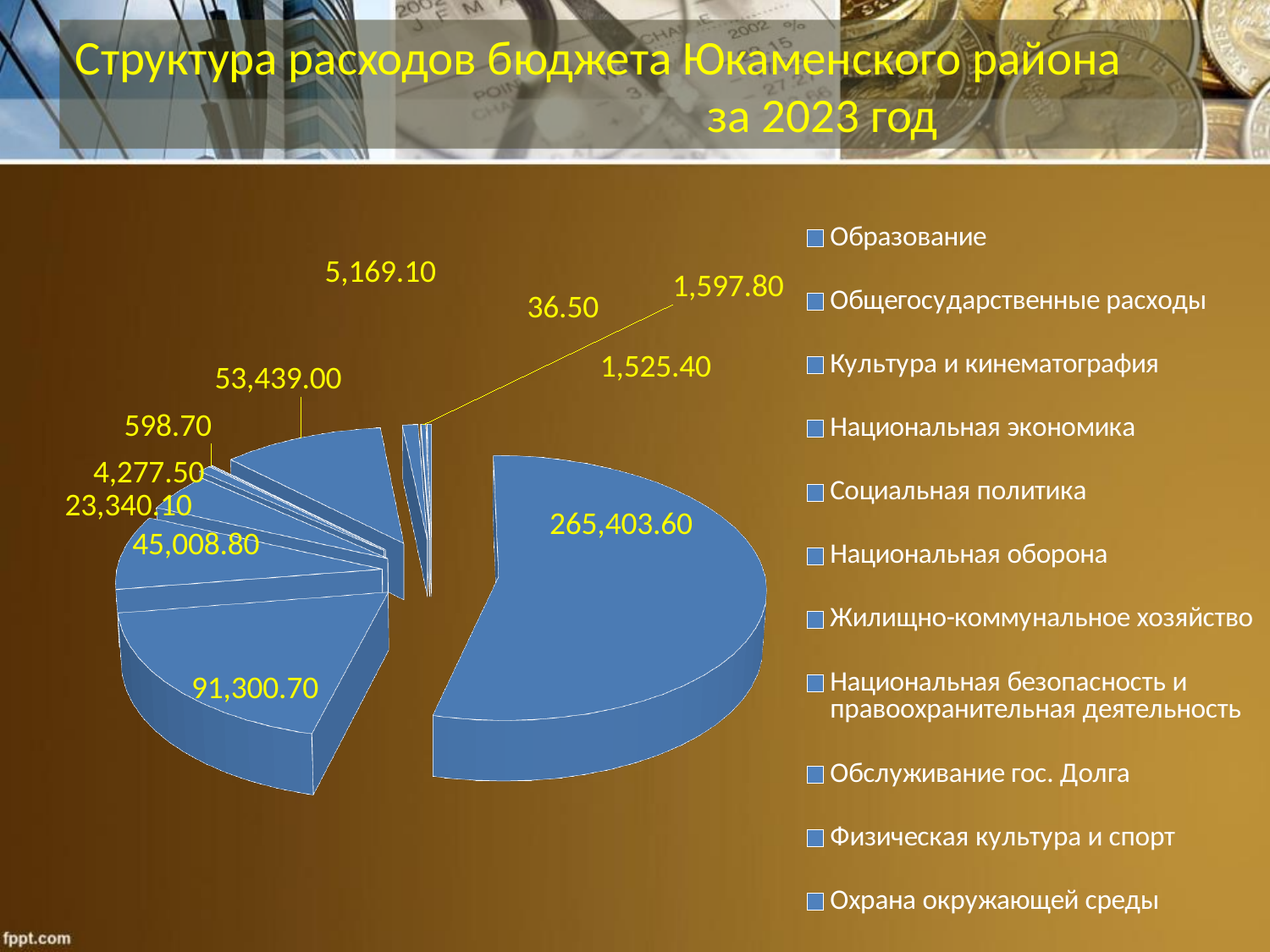
Which slice is larger: the one labelled 1,597.80 or the one labelled 1,525.40? 1,597.80 What is the value of the second largest slice of the pie chart? 91,300.70 What kind of chart is shown on the slide? pie chart How many entries does the legend of the pie chart list? 11 What is the value of the smallest slice of the pie chart? 36.50 Which slice is larger: the one labelled 5,169.10 or the one labelled 4,277.50? 5,169.10 How many slices are labelled with values on the pie chart? 11 Which legend entry is listed first in the pie chart's legend? Образование What is the difference between the largest slice (265,403.60) and the second largest slice (91,300.70)? 174,102.90 What is the title of the chart on the slide? Структура расходов бюджета Юкаменского района за 2023 год What is the difference between the slices labelled 53,439.00 and 45,008.80? 8,430.20 What is the value of the largest slice of the pie chart? 265,403.60